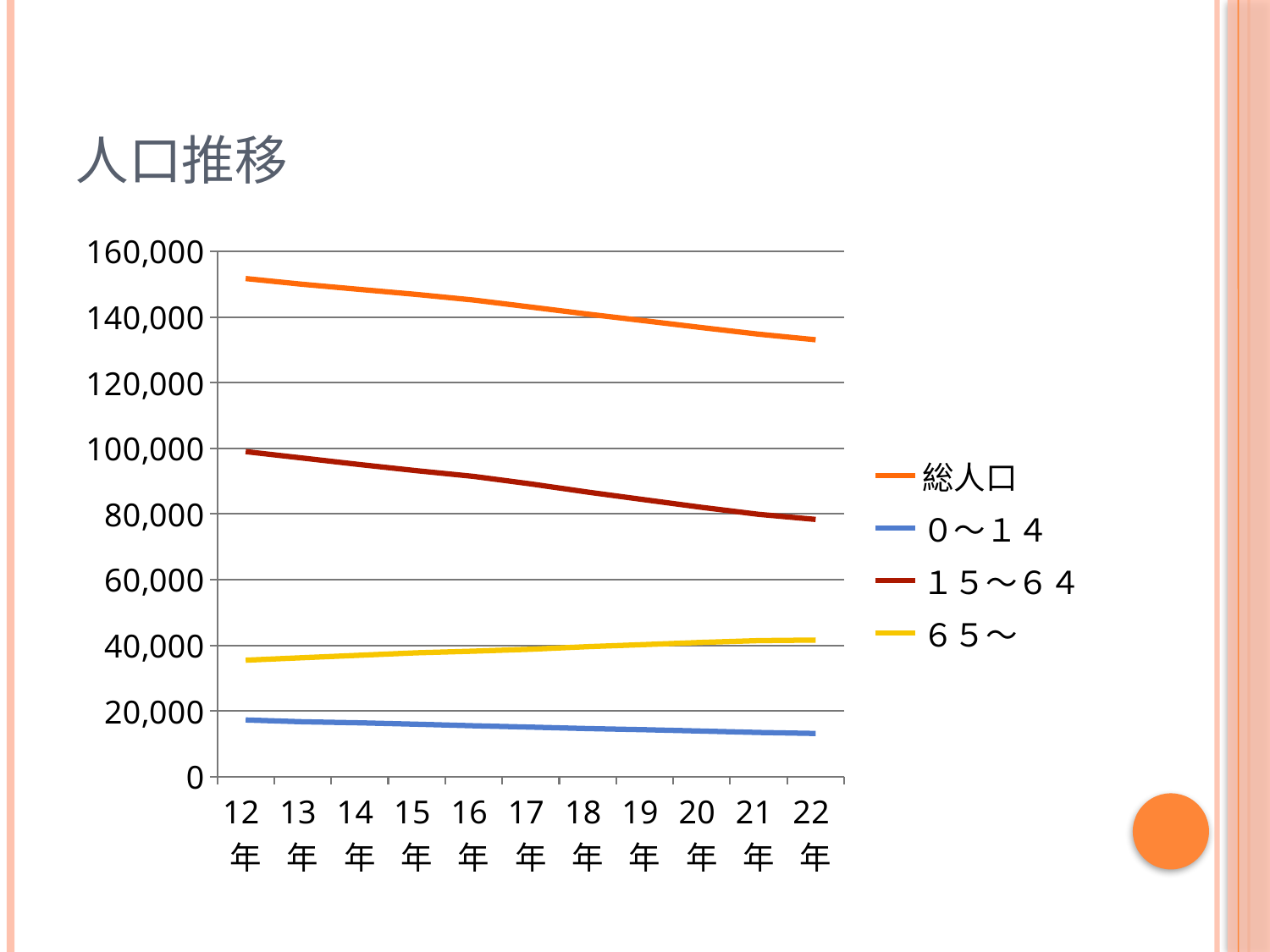
What kind of chart is shown on the slide? line chart Is the value for ０～１４ in 12年 greater or less than 20,000? less Does the ６５～ line rise or fall from 12年 to 22年? rise Is the value for 総人口 in 22年 greater or less than 140,000? less Which series is drawn in yellow according to the legend? ６５～ What is the title of the chart? 人口推移 Is the value for 総人口 in 12年 greater or less than 140,000? greater How many years are plotted along the x axis? 11 How many series does the legend list? 4 Does the 総人口 line rise or fall from 12年 to 22年? fall Which series has the lowest values throughout the chart? ０～１４ Does the ０～１４ line rise or fall from 12年 to 22年? fall